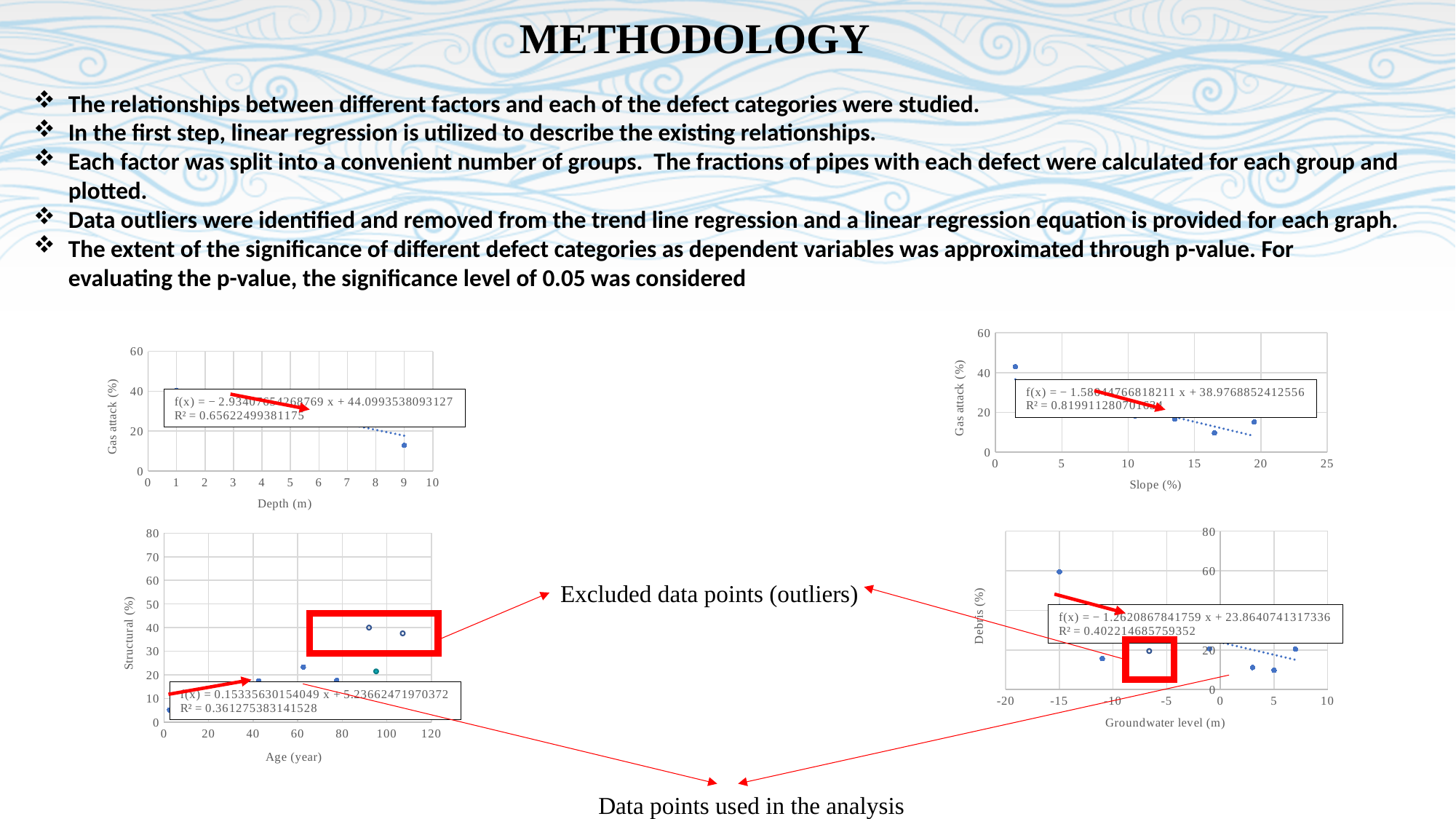
In the top-right chart (Gas attack (%) vs Slope (%)), is the Gas attack value for the point at a slope of about 1.5% greater or less than 40? greater In the bottom-right chart (Debris (%) vs Groundwater level (m)), what is the regression equation printed on the chart? f(x) = − 1.2620867841759 x + 23.8640741317336 In the bottom-right chart (Debris (%) vs Groundwater level (m)), is the Debris value for the point at a groundwater level of about -15 m greater or less than 40? greater How many charts are shown on the slide? 4 What is the x-axis title of the bottom-right chart on the slide? Groundwater level (m) In the bottom-left chart (Structural (%) vs Age (year)), what is the regression equation printed on the chart? f(x) = 0.15335630154049 x + 5.23662471970372 In the top-left chart (Gas attack (%) vs Depth (m)), what is the R² value printed on the chart? 0.65622499381175 In the bottom-left chart (Structural (%) vs Age (year)), does the dotted trend line rise or fall as age increases? rise In the bottom-left chart (Structural (%) vs Age (year)), what is the R² value printed on the chart? 0.361275383141528 In the top-right chart (Gas attack (%) vs Slope (%)), does the dotted trend line rise or fall as slope increases? fall In the bottom-right chart (Debris (%) vs Groundwater level (m)), what is the R² value printed on the chart? 0.402214685759352 What kind of chart is the chart titled with the x axis 'Depth (m)' at the top left of the slide? scatter chart